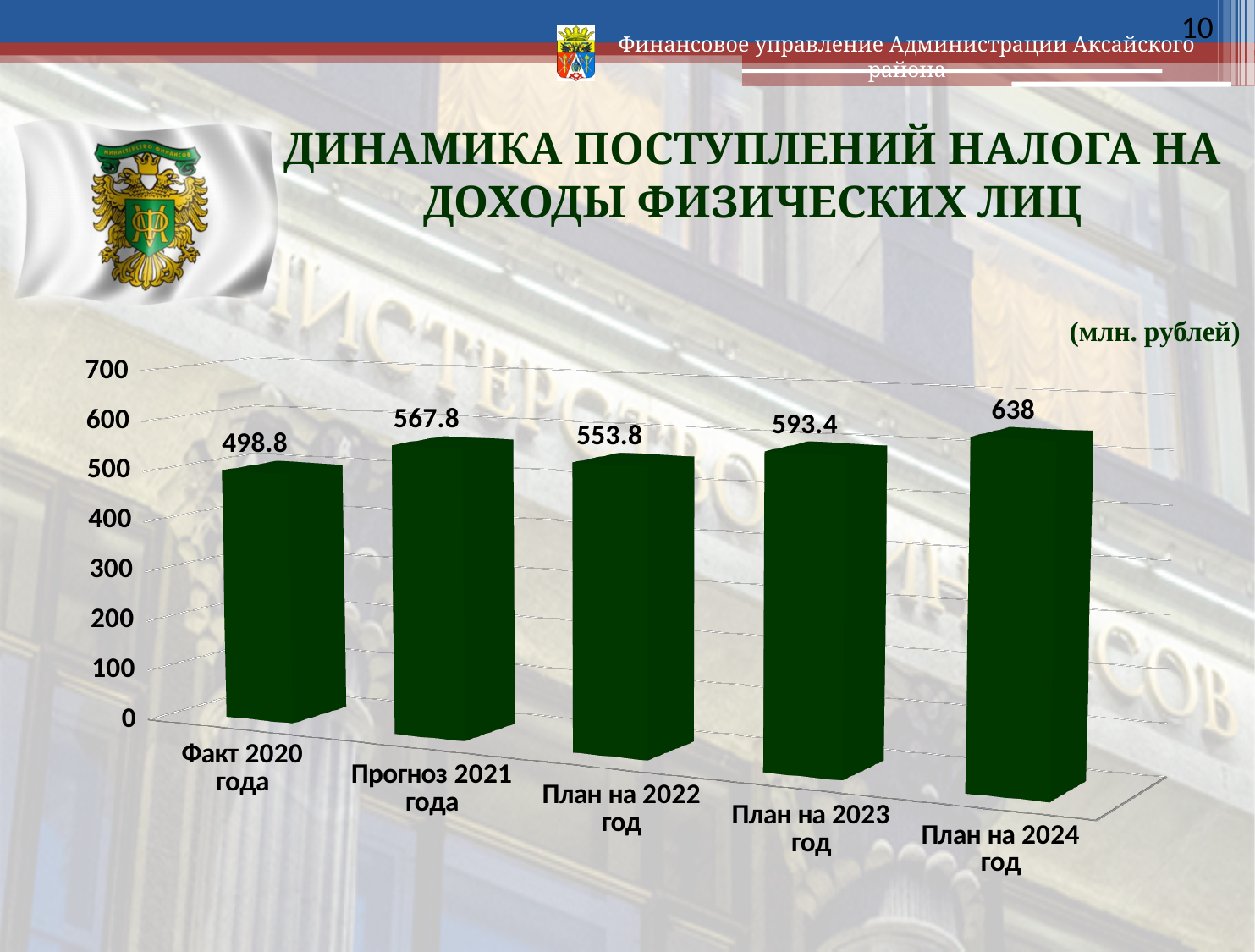
Which category has the highest value? План на 2024 год What kind of chart is shown on the slide? bar chart What is the value for План на 2022 год? 553.8 What is the value for Факт 2020 года? 498.8 What unit is indicated for the chart values? млн. рублей How many categories are shown on the chart? 5 What is the value for Прогноз 2021 года? 567.8 Is the value for План на 2023 год greater or less than 500? greater What is the value for План на 2024 год? 638 What is the difference between the values for План на 2024 год and План на 2023 год? 44.6 Which category has the lowest value? Факт 2020 года Which is larger, the value for Прогноз 2021 года or the value for План на 2022 год? Прогноз 2021 года